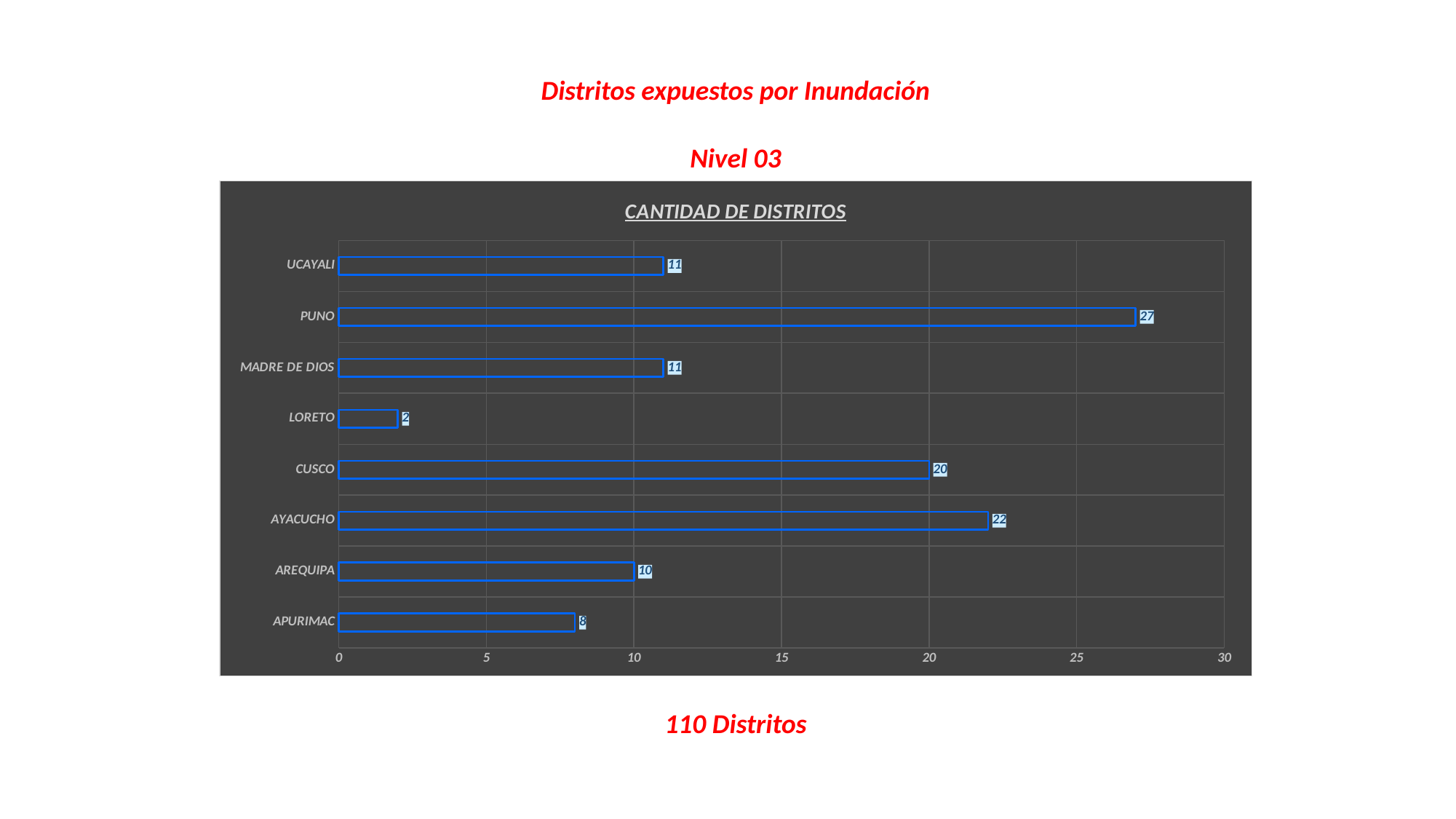
What is the difference between the values for PUNO and CUSCO? 7 Which category has the highest value? PUNO What is the value for AYACUCHO? 22 How many categories are shown in the chart? 8 What is the value for PUNO? 27 What is the value for APURIMAC? 8 What kind of chart is shown on the slide? bar chart What is the value for LORETO? 2 Which category has the lowest value? LORETO What is the title of the chart? CANTIDAD DE DISTRITOS Which is larger, the value for AYACUCHO or the value for CUSCO? AYACUCHO Is the value for AREQUIPA greater or less than 15? less